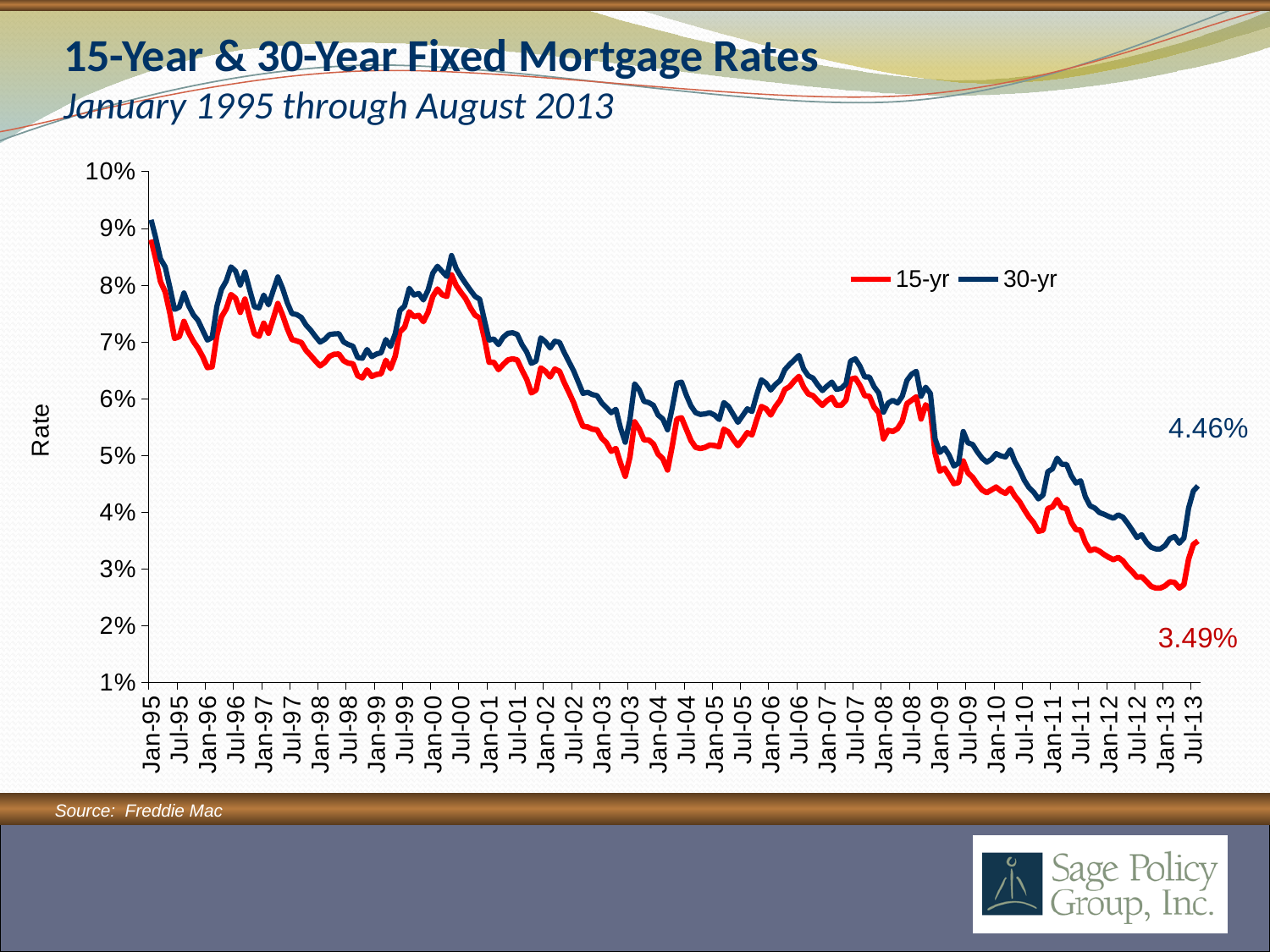
Is the 15-yr rate at Jan-13 greater or less than 3%? less Overall, do mortgage rates rise or fall from Jan-95 to Jul-13? fall What is the labelled value of the 30-yr series at the end of the chart (Jul-13)? 4.46% What is the labelled value of the 15-yr series at the end of the chart (Jul-13)? 3.49% Is the 15-yr rate at Jan-95 greater or less than 8%? greater Which colour is used for the 30-yr series? blue At the end of the chart, which series has the higher rate, 15-yr or 30-yr? 30-yr What is the title of the chart? 15-Year & 30-Year Fixed Mortgage Rates What is the difference between the final labelled 30-yr rate and the final labelled 15-yr rate? 0.97% What type of chart is shown on the slide? line chart How many series does the legend list? 2 Is the 30-yr rate at Jan-13 greater or less than 4%? less